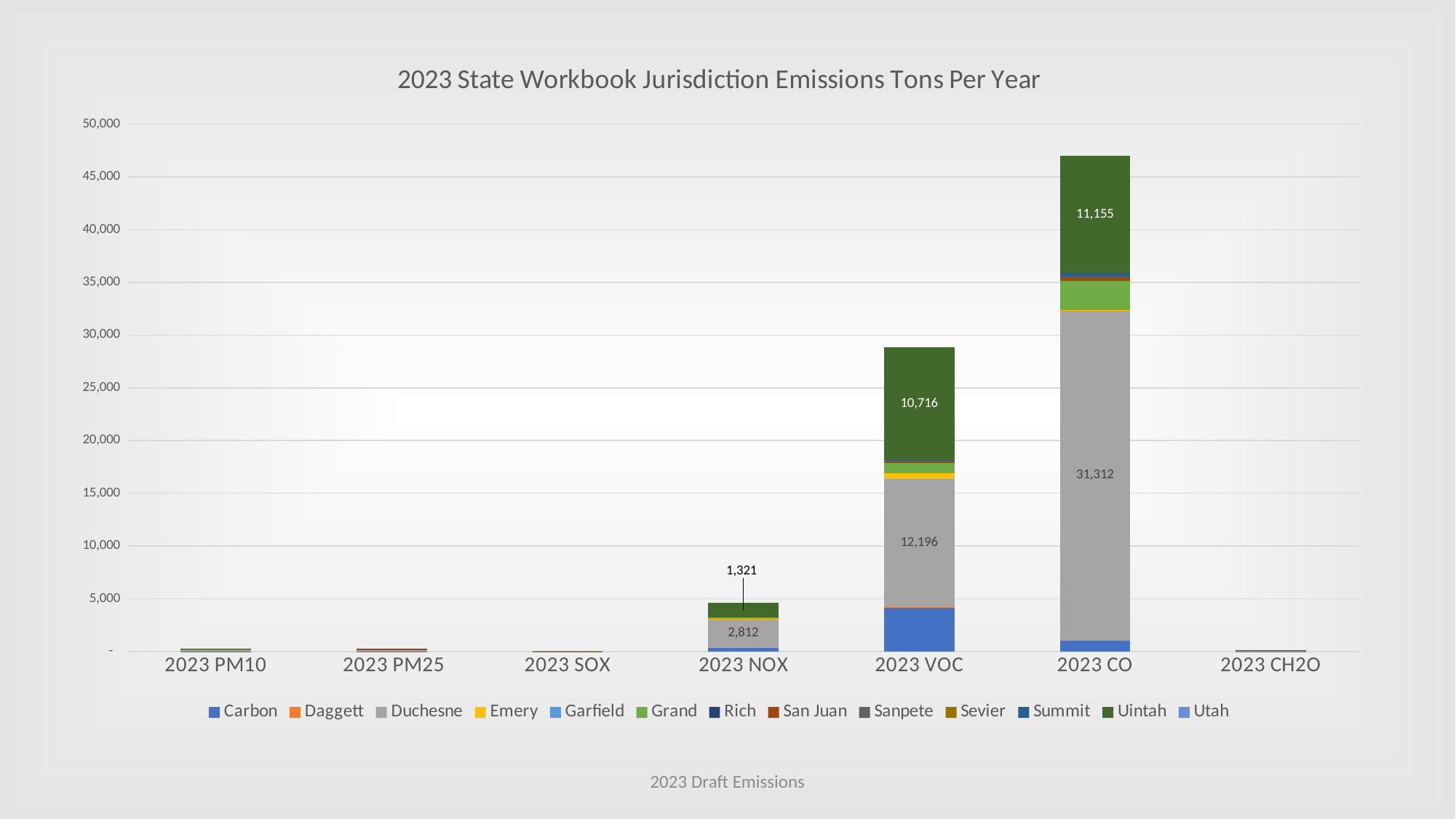
How many jurisdictions does the legend list? 13 Which pollutant category has the tallest stacked bar? 2023 CO In the 2023 VOC bar, which is larger: the Duchesne segment or the Uintah segment? Duchesne What type of chart is shown on the slide? Stacked bar chart What is the Uintah value for 2023 VOC? 10,716 What is the Duchesne value for 2023 CO? 31,312 What is the difference between the Duchesne values for 2023 CO and 2023 VOC? 19,116 What is the Uintah value for 2023 NOX? 1,321 How many pollutant categories are shown on the x axis? 7 Is the total of the 2023 CO stacked bar greater or less than 45,000? greater What is the title of the chart? 2023 State Workbook Jurisdiction Emissions Tons Per Year What is the Duchesne value for 2023 NOX? 2,812